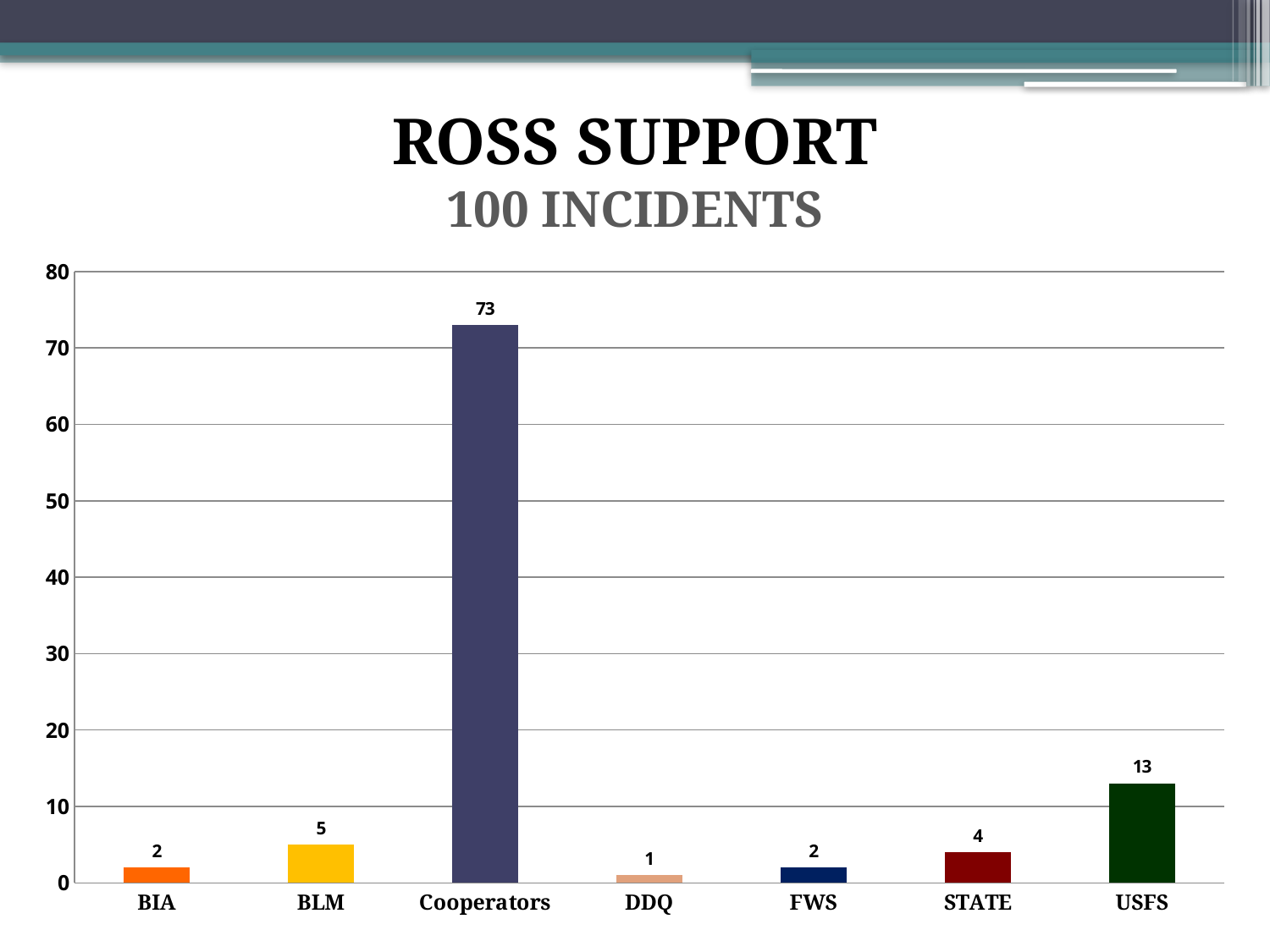
What is the value for STATE? 4 What kind of chart is shown on the slide? Bar chart Which category has the lowest value? DDQ What is the difference between the values for Cooperators and USFS? 60 Which is larger, the value for USFS or the value for BLM? USFS What is the value for USFS? 13 What is the value for Cooperators? 73 Which category has the highest value? Cooperators What is the difference between the values for BLM and STATE? 1 What is the title of the slide? ROSS SUPPORT 100 INCIDENTS What is the value for BLM? 5 How many categories are shown on the x axis? 7